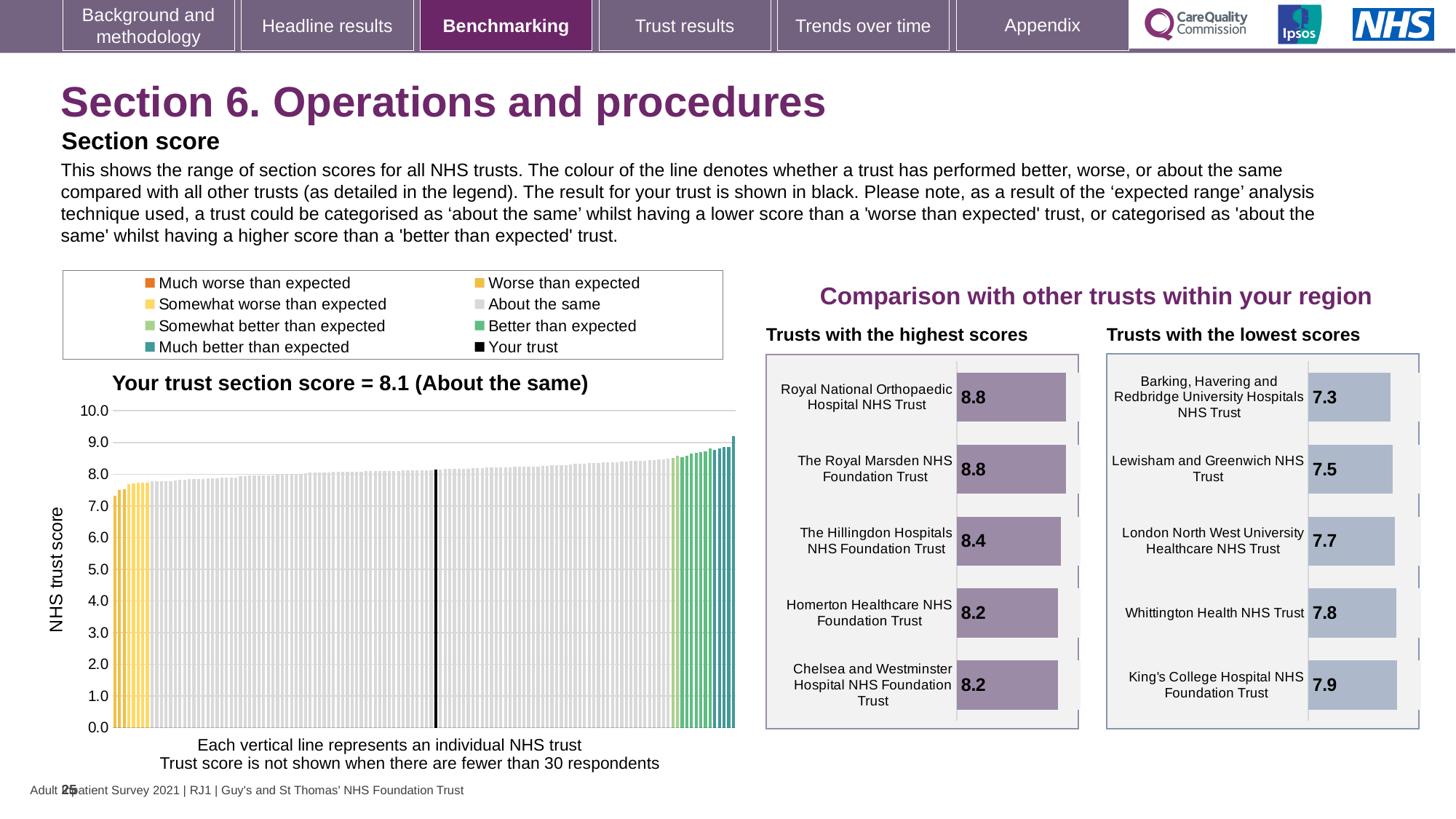
In the 'Your trust section score' chart, do the trust scores rise or fall from left to right along the x axis? rise In the 'Your trust section score' chart, is the value of the leftmost (lowest) bar greater or less than 8.0? less In the chart titled 'Your trust section score', which category does your trust fall into according to the title? About the same How many trusts are shown in the 'Trusts with the highest scores' chart? 5 In the 'Trusts with the highest scores' chart, what is the score for The Hillingdon Hospitals NHS Foundation Trust? 8.4 In the 'Trusts with the lowest scores' chart, which trust has the highest score? King's College Hospital NHS Foundation Trust In the 'Trusts with the lowest scores' chart, which trust has the lowest score? Barking, Havering and Redbridge University Hospitals NHS Trust What kind of chart is the 'Your trust section score' chart? bar chart In the chart titled 'Your trust section score', what is the section score for your trust? 8.1 In the 'Trusts with the lowest scores' chart, what is the score for Whittington Health NHS Trust? 7.8 In the 'Trusts with the highest scores' chart, what is the difference between the score for Royal National Orthopaedic Hospital NHS Trust and the score for The Hillingdon Hospitals NHS Foundation Trust? 0.4 How many entries does the legend above the 'Your trust section score' chart list? 8